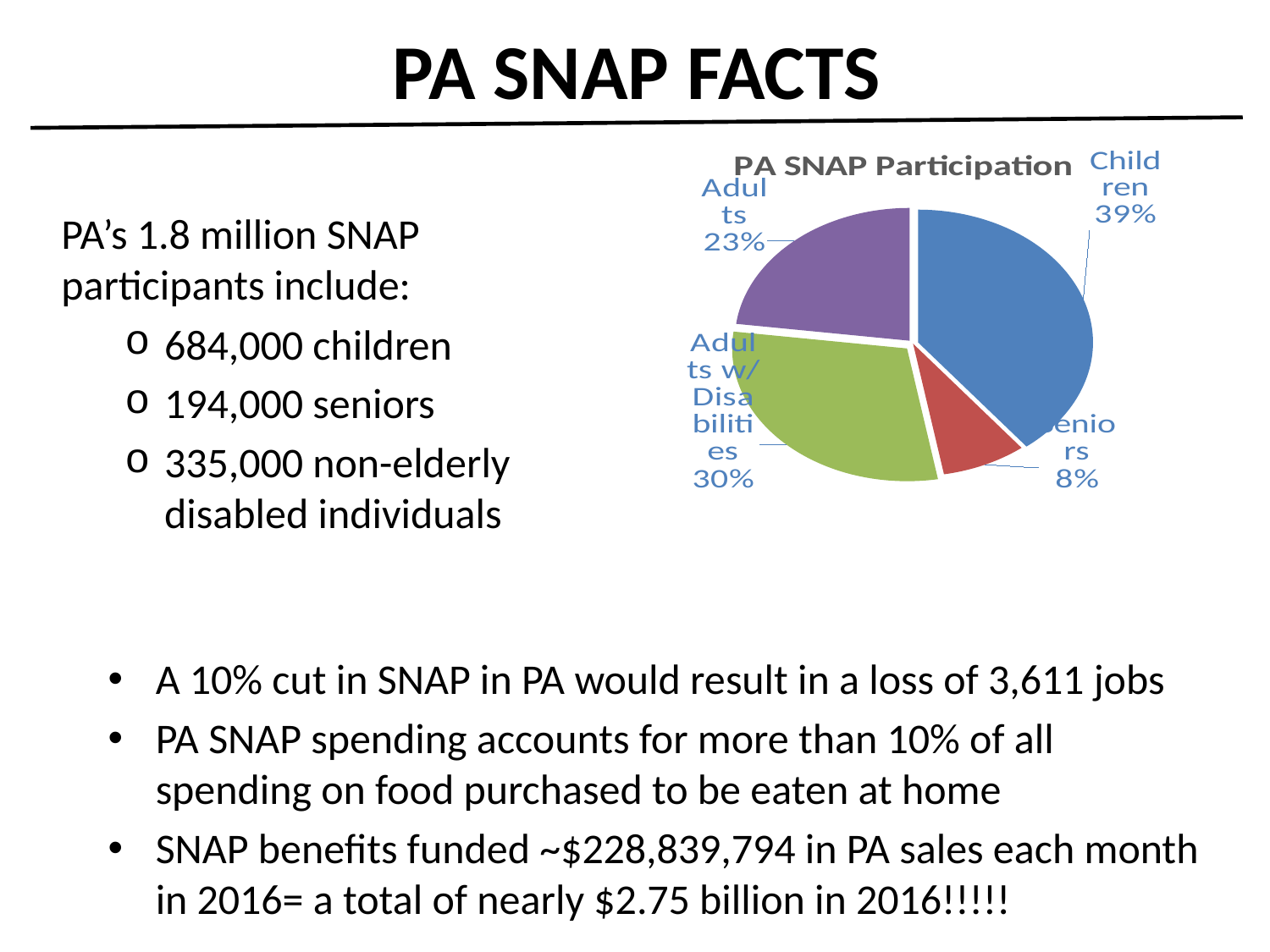
Which share is larger, Adults w/ Disabilities or Adults? Adults w/ Disabilities What is the title of the chart? PA SNAP Participation Which group has the smallest share of PA SNAP participation? Seniors What share of PA SNAP participation is Children? 39% What share of PA SNAP participation is Seniors? 8% What type of chart is shown on the slide? pie chart Which group has the largest share of PA SNAP participation? Children What is the difference in percentage points between the Children and Seniors shares? 31 What is the difference in percentage points between the Adults w/ Disabilities and Adults shares? 7 What share of PA SNAP participation is Adults w/ Disabilities? 30% How many slices does the pie chart have? 4